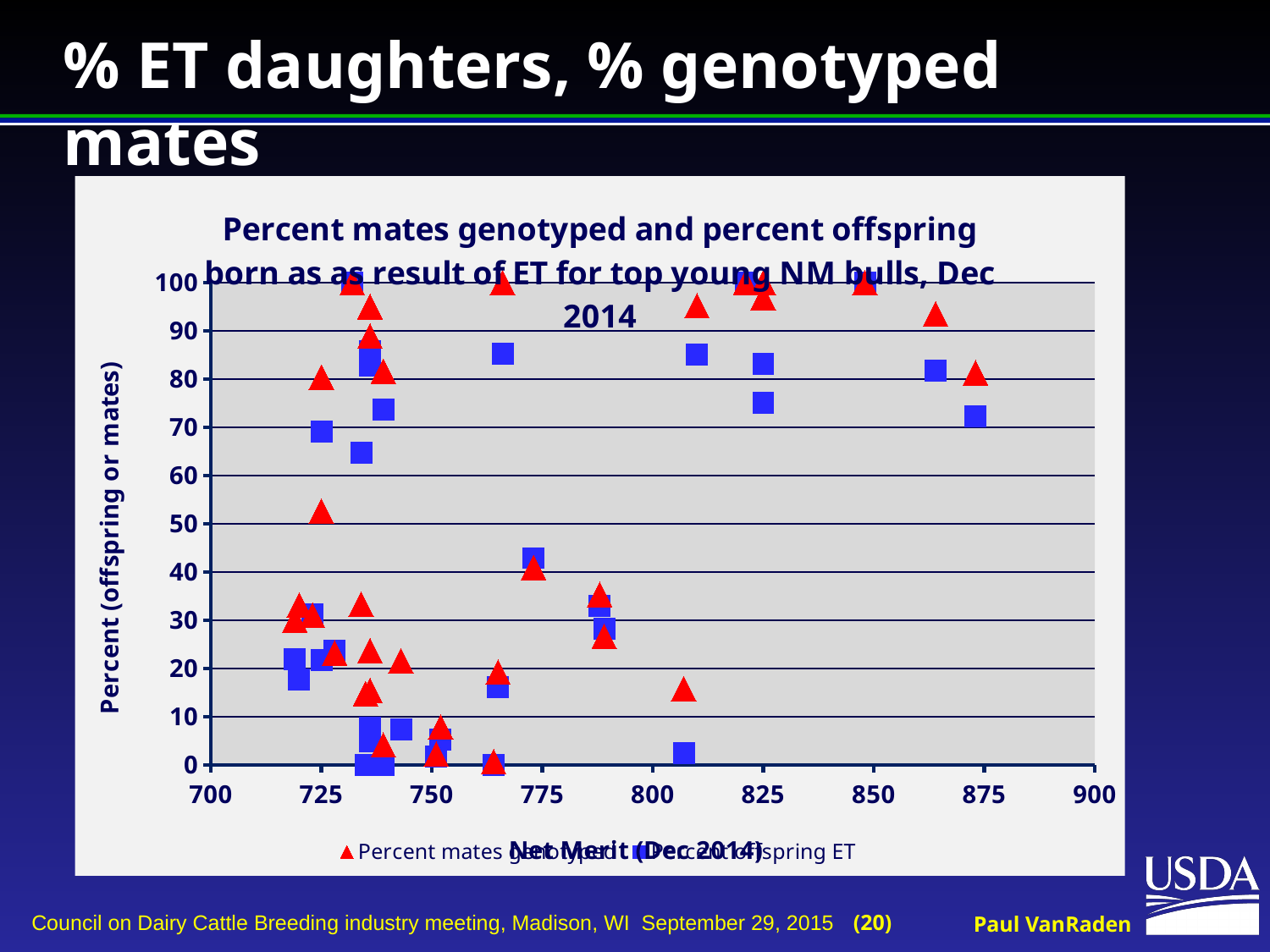
For the bull near Net Merit 765 with the highest values, which series is higher, Percent mates genotyped or Percent offspring ET? Percent mates genotyped What kind of chart is shown on the slide? scatter chart Is the highest Percent offspring ET value on the chart greater or less than 80? greater Which marker shape and colour represents the Percent mates genotyped series? red triangles Is the lowest Percent mates genotyped value on the chart greater or less than 10? less Is the Percent mates genotyped value for the bull near Net Merit 850 greater or less than 90? greater For the bull near Net Merit 875, which series has the higher value, Percent mates genotyped or Percent offspring ET? Percent mates genotyped What is the label on the vertical axis of the chart? Percent (offspring or mates) How many series does the chart's legend list? 2